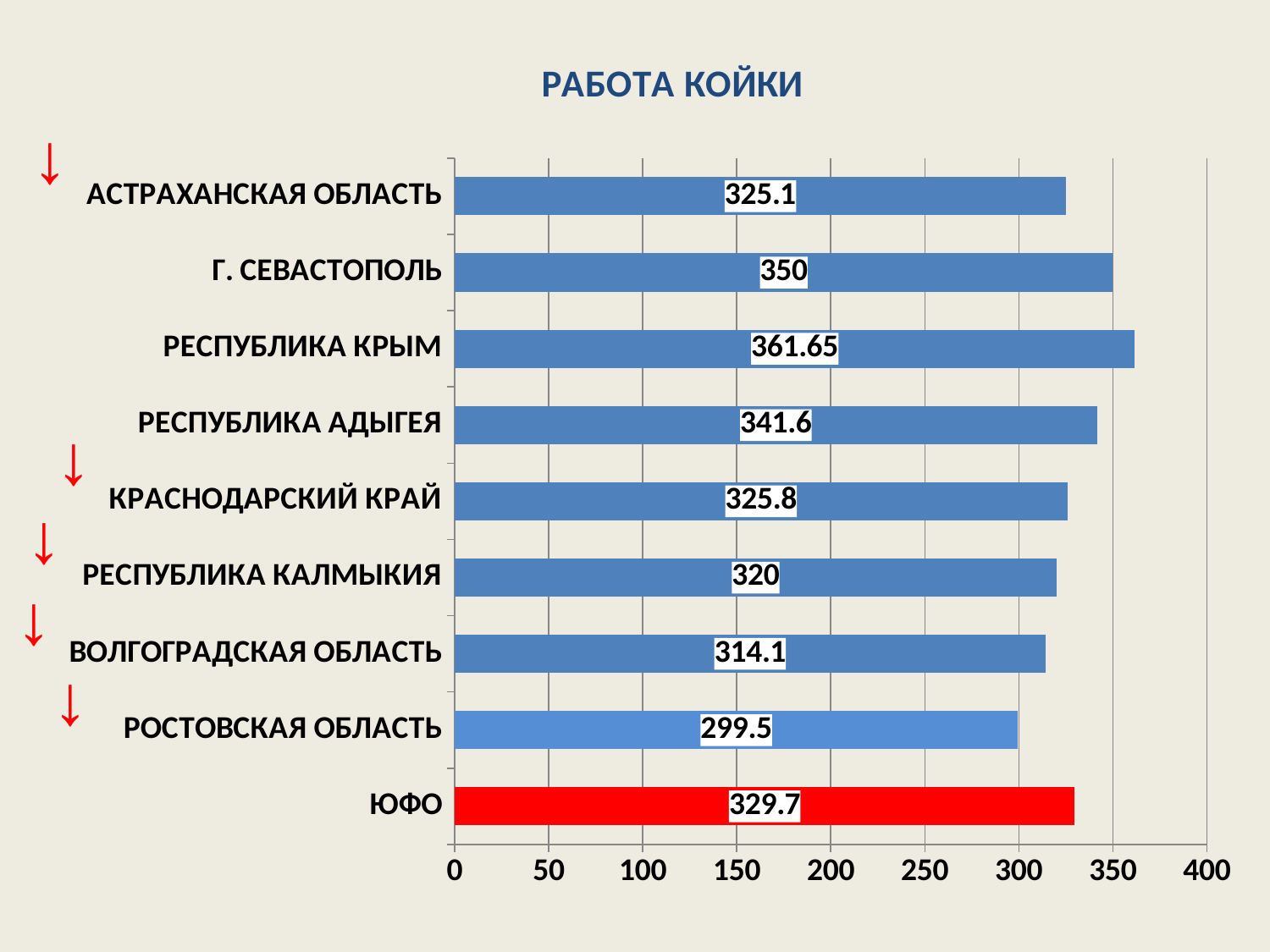
How many categories are shown in the chart? 9 What is the title of the chart? РАБОТА КОЙКИ What is the difference between the values for г. Севастополь and Ростовская область? 50.5 Which category has the highest value? Республика Крым Is the value for Ростовская область greater or less than 300? less What is the difference between the values for Республика Адыгея and Республика Калмыкия? 21.6 What is the value for Республика Крым? 361.65 Which is larger, the value for Республика Адыгея or the value for Волгоградская область? Республика Адыгея What is the value for Ростовская область? 299.5 Which category has the lowest value? Ростовская область What is the value for ЮФО? 329.7 What kind of chart is shown on the slide? bar chart